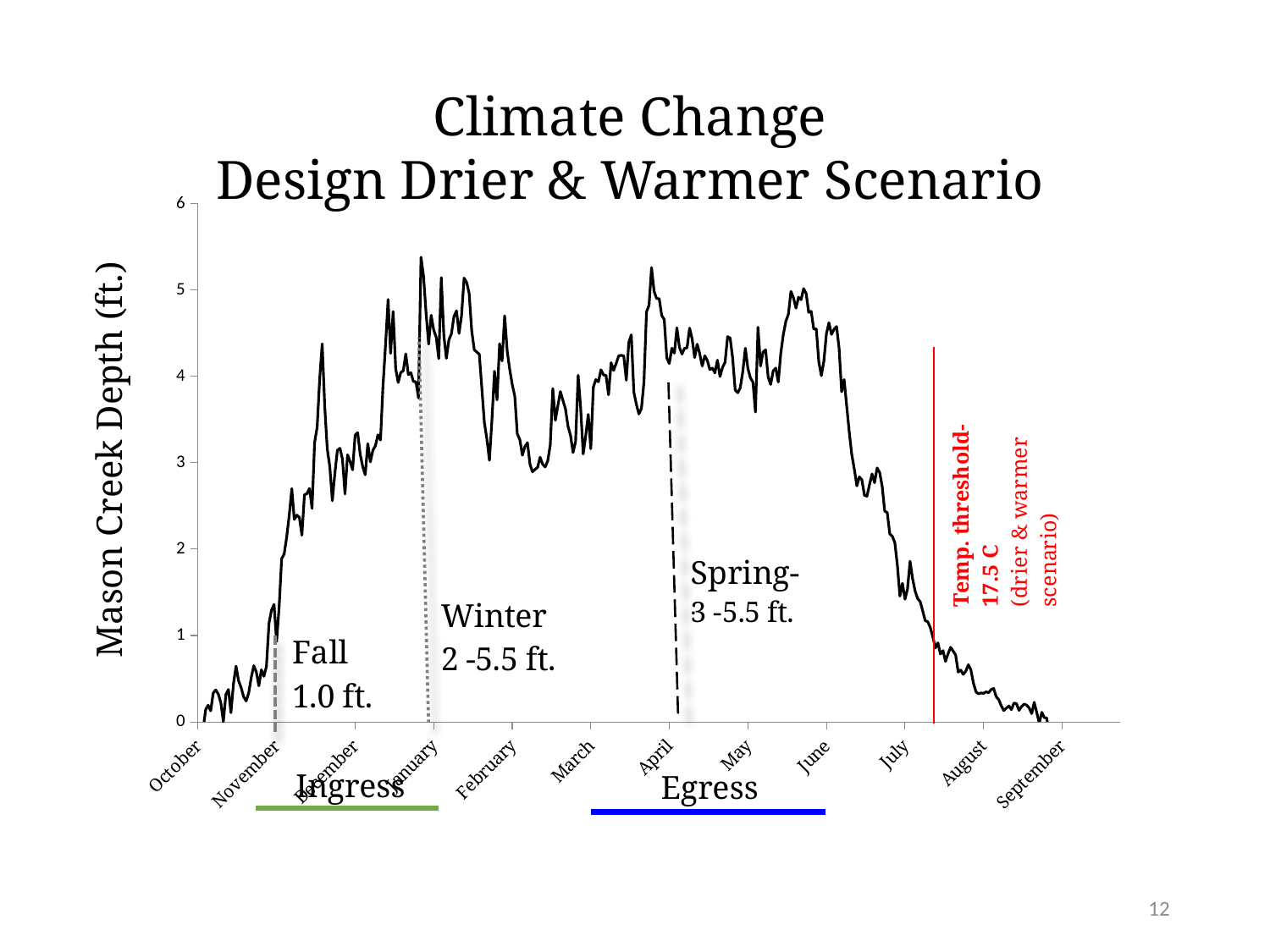
Is the creek depth at the August tick greater or less than 2? less How many month labels are shown along the x axis? 12 Does the creek depth rise or fall from June to September? falls Does the creek depth rise or fall from October to November? rises Is the creek depth higher at the January tick or at the September tick? January What temperature threshold is marked by the red vertical line? 17.5 C Is the creek depth at the start of October greater or less than 1? less What is the label on the y axis? Mason Creek Depth (ft.) Is the creek depth at the end of September greater or less than 1? less What kind of chart is shown on the slide? line chart